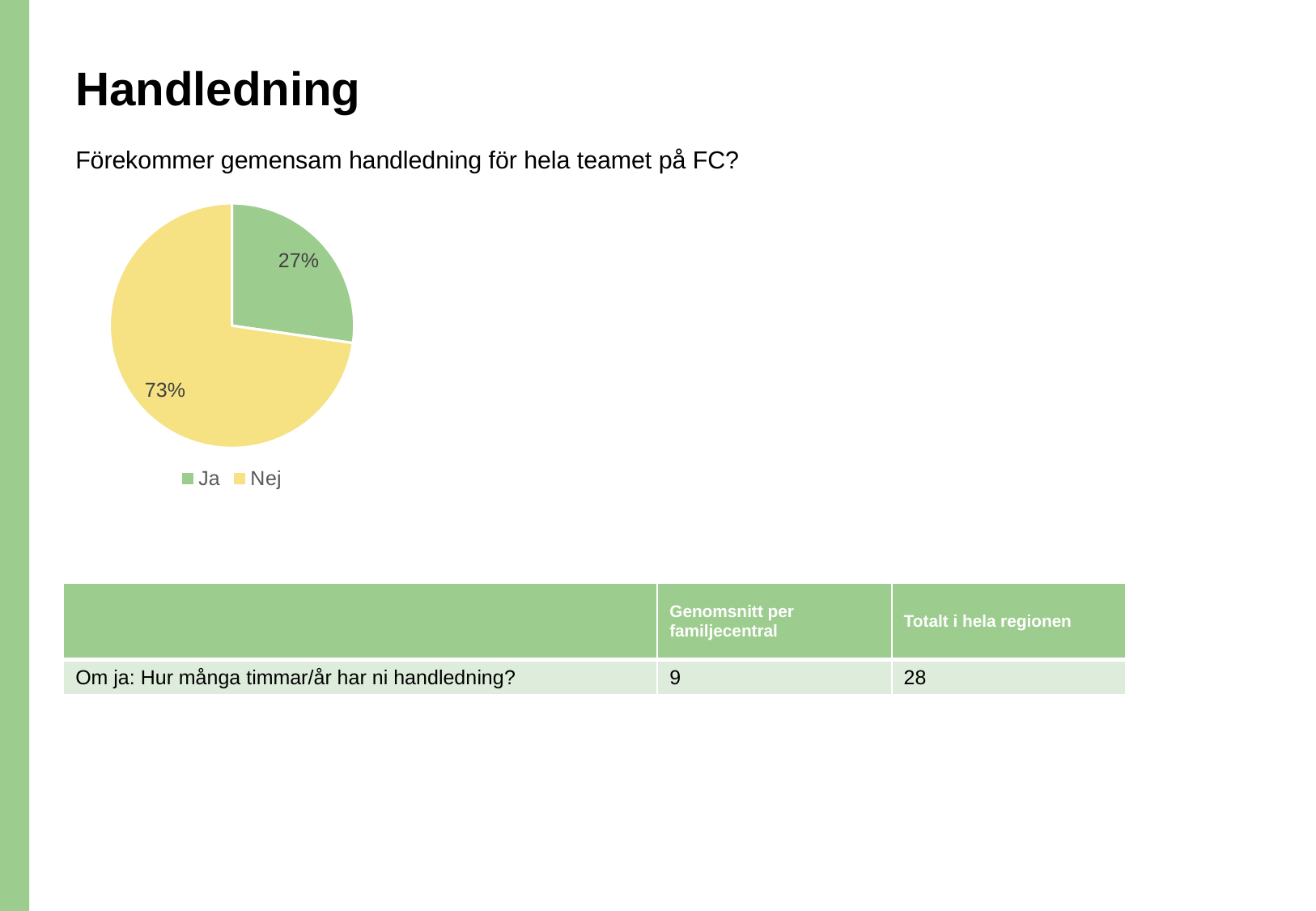
What is the difference in percentage points between the "Nej" and "Ja" slices? 46 Which slice of the pie is the largest? Nej What question does the pie chart answer, according to the text above it? Förekommer gemensam handledning för hela teamet på FC? What colour is the "Ja" slice in the pie chart? green What share of the pie does "Ja" represent? 27% What kind of chart is shown on the slide? pie chart Which slice of the pie is the smallest? Ja What share of the pie does "Nej" represent? 73% How many entries does the legend list? 2 Is the share for "Ja" greater or less than 50%? less How many slices does the pie chart have? 2 Which is larger, the "Ja" slice or the "Nej" slice? Nej